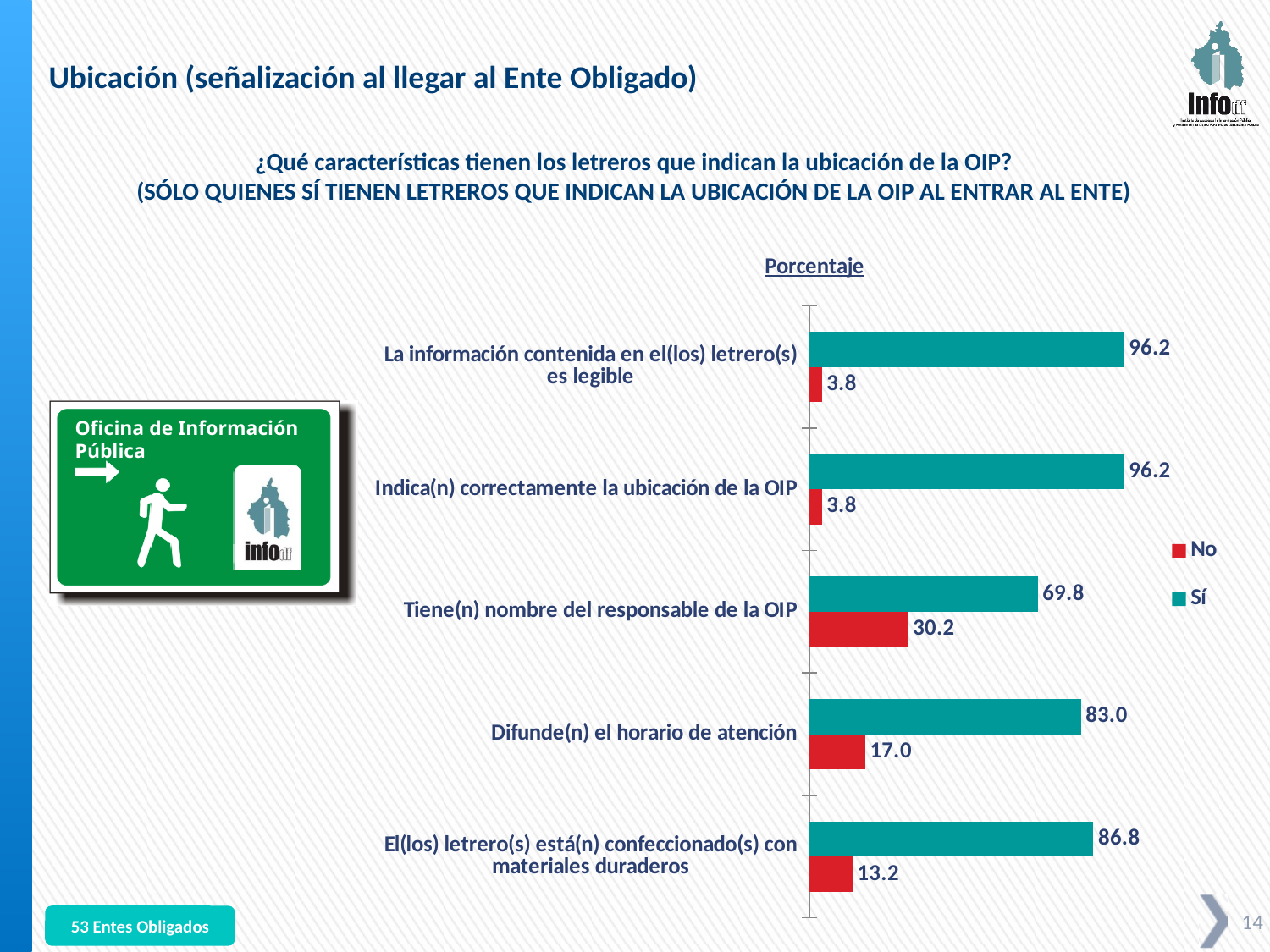
What is the 'No' value for 'Difunde(n) el horario de atención'? 17.0 What is the 'No' value for 'Indica(n) correctamente la ubicación de la OIP'? 3.8 What kind of chart is shown on the slide? Bar chart How many categories are shown in the chart? 5 Which colour represents the 'No' series in the chart? Red What is the difference between the 'Sí' and 'No' values for 'Difunde(n) el horario de atención'? 66.0 What is the 'Sí' value for 'Tiene(n) nombre del responsable de la OIP'? 69.8 Which category has the highest 'No' value? Tiene(n) nombre del responsable de la OIP How many series does the legend list? 2 Which is larger: the 'Sí' value for 'Difunde(n) el horario de atención' or the 'Sí' value for 'El(los) letrero(s) está(n) confeccionado(s) con materiales duraderos'? El(los) letrero(s) está(n) confeccionado(s) con materiales duraderos Which category has the lowest 'Sí' value? Tiene(n) nombre del responsable de la OIP What is the 'Sí' value for 'El(los) letrero(s) está(n) confeccionado(s) con materiales duraderos'? 86.8